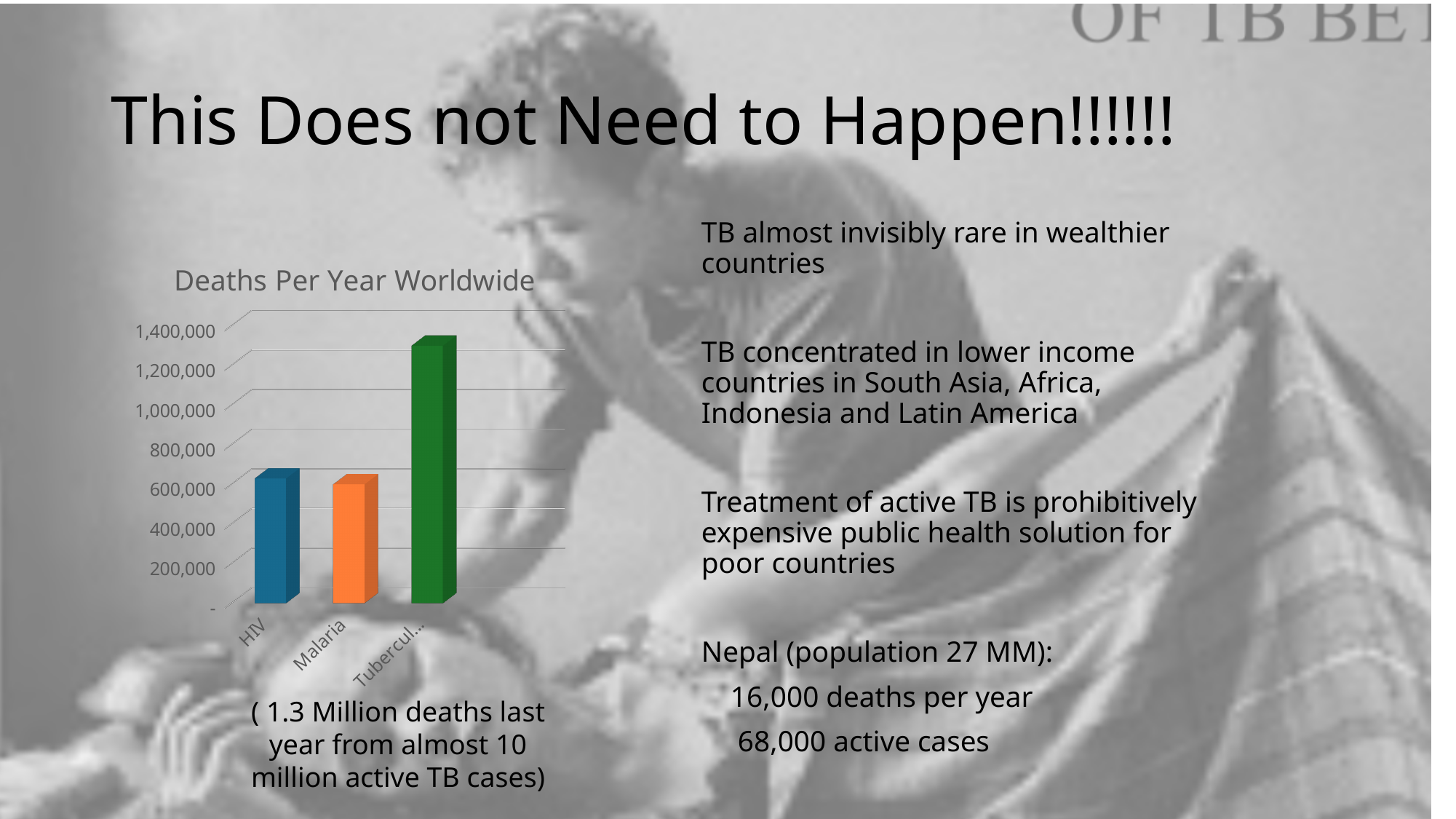
What colour is the Tuberculosis bar in the Deaths Per Year Worldwide chart? green In the Deaths Per Year Worldwide chart, is the value for Malaria greater or less than 400,000? greater How many categories are plotted in the Deaths Per Year Worldwide chart? 3 In the Deaths Per Year Worldwide chart, is the value for Tuberculosis greater or less than 1,200,000? greater In the Deaths Per Year Worldwide chart, is the value for HIV greater or less than 800,000? less What is the title of the chart on the slide? Deaths Per Year Worldwide In the Deaths Per Year Worldwide chart, which is larger, the value for Tuberculosis or the value for Malaria? Tuberculosis Which category has the highest value in the Deaths Per Year Worldwide chart? Tuberculosis What kind of chart is shown on the slide? bar chart